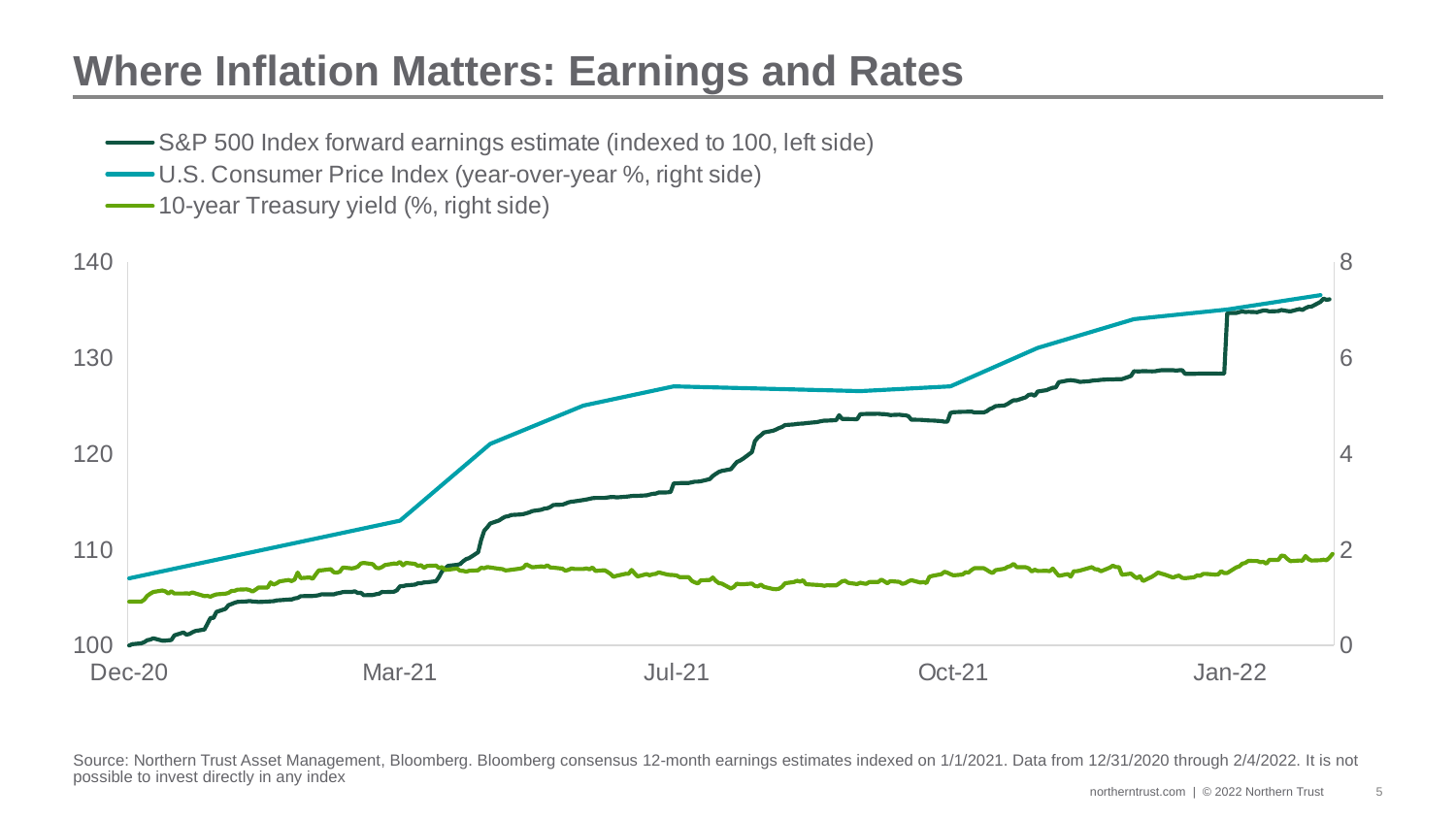
Does the U.S. Consumer Price Index (year-over-year %) rise or fall from Dec-20 to Jan-22? rise How many series does the legend list? 3 Is the 10-year Treasury yield at Jul-21 greater or less than 2 on the right axis? less How many month labels are shown on the x axis? 5 Is the value of the U.S. Consumer Price Index at Jan-22 greater or less than 6 on the right axis? greater At Jan-22, which is larger on the right axis: the U.S. Consumer Price Index or the 10-year Treasury yield? U.S. Consumer Price Index Is the value of the U.S. Consumer Price Index at Mar-21 greater or less than 4 on the right axis? less What kind of chart is shown on the slide? line chart Which axis is the U.S. Consumer Price Index series plotted against, according to the legend? right side Does the S&P 500 Index forward earnings estimate rise or fall over the period shown? rise What is the title of the slide's chart? Where Inflation Matters: Earnings and Rates